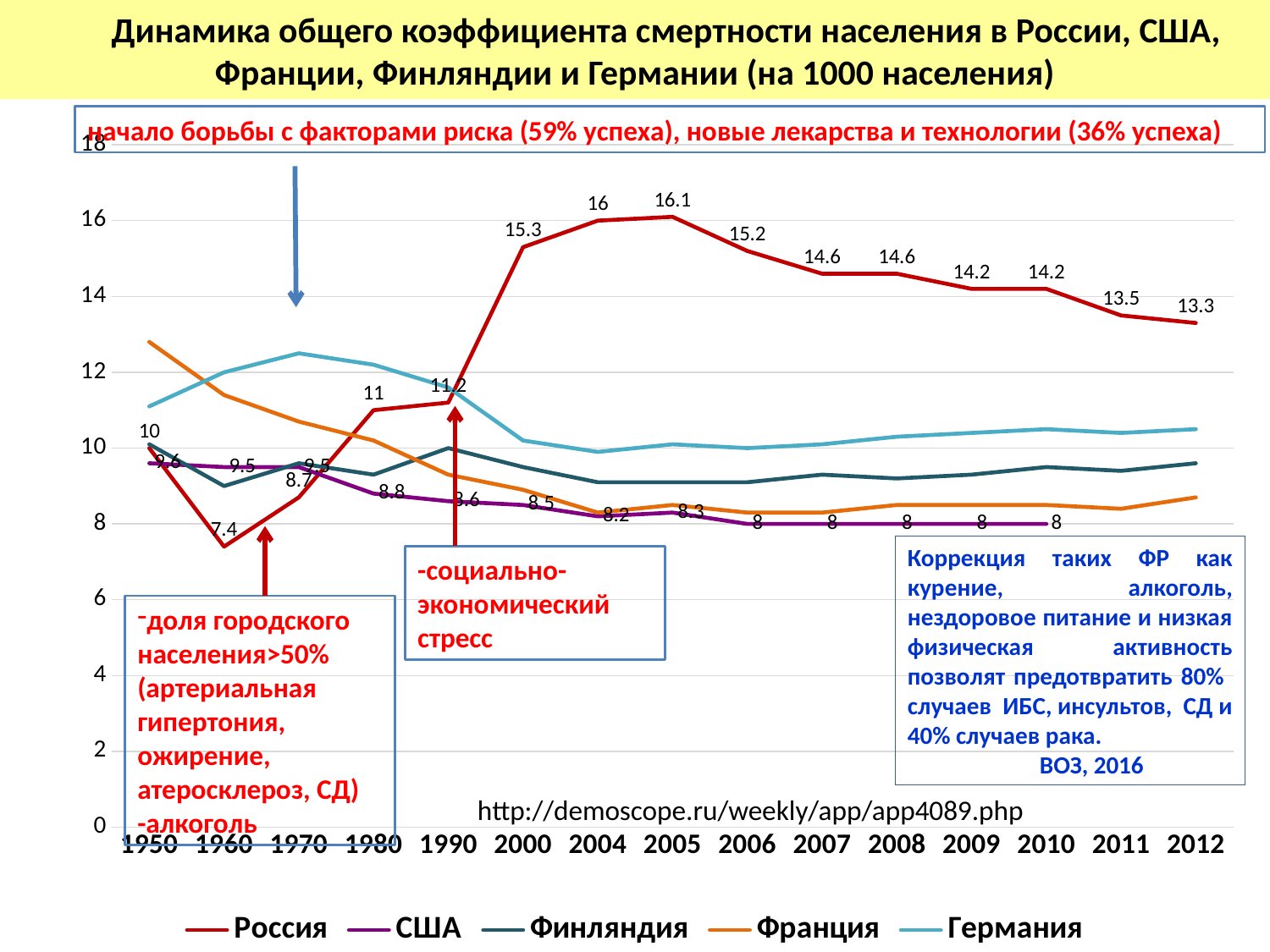
What is the value for Россия in 1960? 7.4 How many years are shown on the x axis? 15 What is the value for Россия in 2005? 16.1 What is the value for США in 1980? 8.8 In which year does the Россия series have its lowest value? 1960 What kind of chart is shown on the slide? line chart What is the difference between the Россия values in 2000 and 2012? 2 In which year does the Россия series reach its highest value? 2005 Does the Россия series rise or fall from 2005 to 2012? fall Is the value for Германия in 1970 greater or less than 12? greater Which is larger in 2004: the value for Россия or the value for США? Россия How many series does the legend list? 5